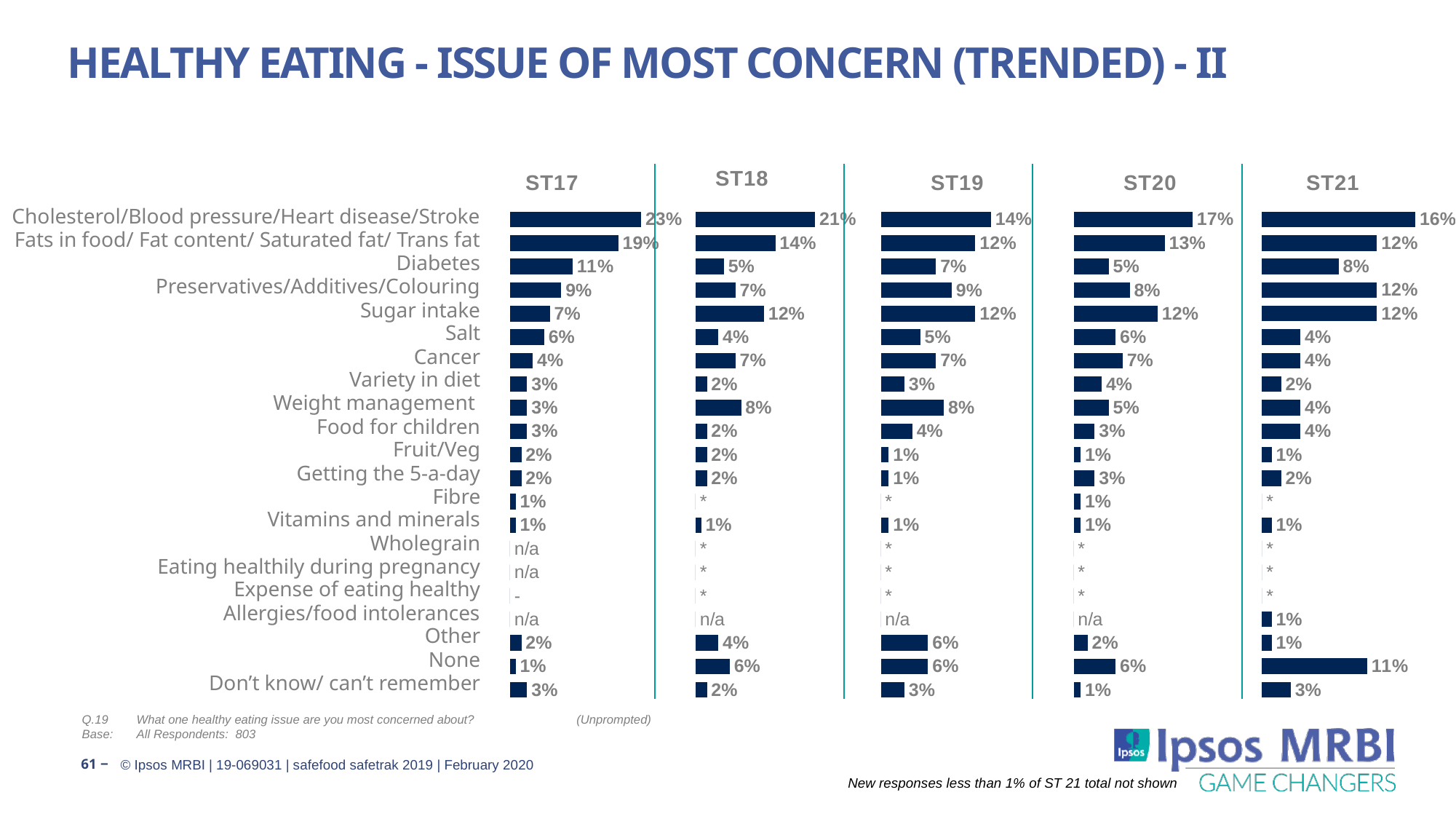
In the ST21 chart, what is the difference between None and Other? 10 percentage points In the ST20 chart, what is the value for Salt? 6% In the ST17 chart, what is the value for Cholesterol/Blood pressure/Heart disease/Stroke? 23% What kind of chart is used on this slide? Bar chart In the ST21 chart, what is the value for None? 11% In the ST17 chart, what is the difference between Cholesterol/Blood pressure/Heart disease/Stroke and Fats in food/ Fat content/ Saturated fat/ Trans fat? 4 percentage points Across the charts from ST17 to ST21, does the value for Sugar intake rise or fall overall? Rise In the ST20 chart, which category has the highest value? Cholesterol/Blood pressure/Heart disease/Stroke How many survey waves (charts) are shown on the slide? 5 In the ST18 chart, which is larger, Sugar intake or Diabetes? Sugar intake In the ST19 chart, what is the value for Weight management? 8% What is the base (number of respondents) stated on the slide? 803